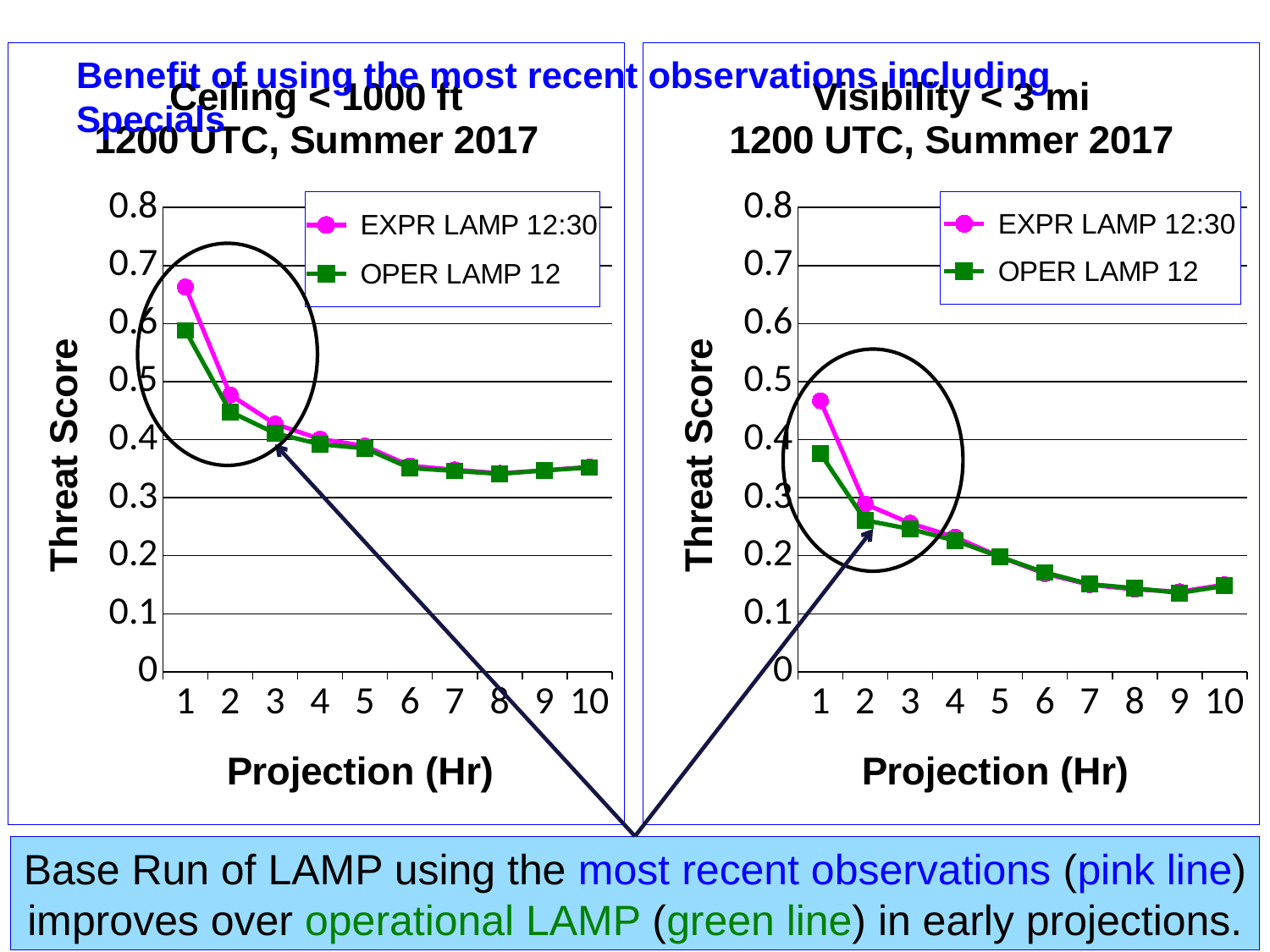
In the 'Visibility < 3 mi' chart on the right, is the OPER LAMP 12 threat score at projection hour 1 greater or less than 0.4? less What is the y-axis title of the 'Ceiling < 1000 ft' chart on the left? Threat Score In the 'Ceiling < 1000 ft' chart on the left, at which projection hour is the EXPR LAMP 12:30 threat score highest? 1 What type of chart is the 'Ceiling < 1000 ft' chart on the left? line chart In the 'Visibility < 3 mi' chart on the right, how many series does the legend list? 2 In the 'Visibility < 3 mi' chart on the right, at which projection hour is the EXPR LAMP 12:30 threat score highest? 1 In the 'Ceiling < 1000 ft' chart on the left, how many projection hours are plotted along the x axis? 10 In the 'Ceiling < 1000 ft' chart on the left, is the EXPR LAMP 12:30 threat score at projection hour 1 greater or less than 0.6? greater In the 'Visibility < 3 mi' chart on the right, does the OPER LAMP 12 threat score rise or fall from projection hour 1 to projection hour 5? fall In the 'Visibility < 3 mi' chart on the right, is the EXPR LAMP 12:30 threat score at projection hour 1 greater or less than 0.4? greater In the 'Visibility < 3 mi' chart on the right, at projection hour 1, which series has the higher threat score, EXPR LAMP 12:30 or OPER LAMP 12? EXPR LAMP 12:30 In the 'Ceiling < 1000 ft' chart on the left, at projection hour 1, which series has the higher threat score, EXPR LAMP 12:30 or OPER LAMP 12? EXPR LAMP 12:30